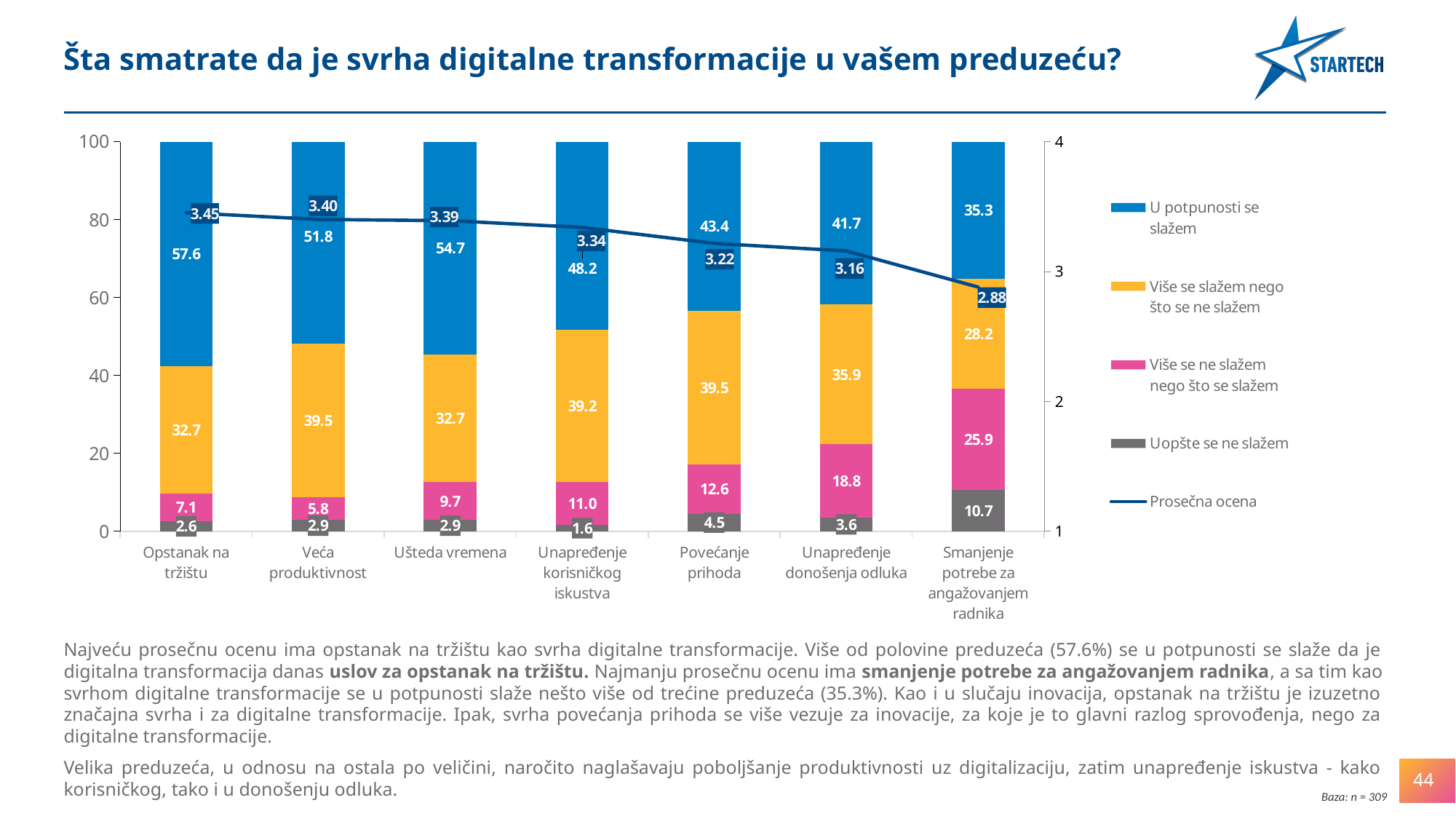
Which category has the highest average score (Prosečna ocena)? Opstanak na tržištu Which category has the lowest value for "U potpunosti se slažem"? Smanjenje potrebe za angažovanjem radnika What is the value of "Uopšte se ne slažem" for "Unapređenje korisničkog iskustva"? 1.6 What is the value of "Više se slažem nego što se ne slažem" for "Veća produktivnost"? 39.5 What kind of chart is this? Stacked bar chart with a line What is the difference between the "U potpunosti se slažem" values for "Opstanak na tržištu" and "Smanjenje potrebe za angažovanjem radnika"? 22.3 How many categories are shown on the x axis? 7 Does the average score line (Prosečna ocena) rise or fall from left to right across the categories? Fall What is the value of "U potpunosti se slažem" for "Opstanak na tržištu"? 57.6 How many entries does the legend list? 5 What is the average score (Prosečna ocena) for "Smanjenje potrebe za angažovanjem radnika"? 2.88 Which is larger: the "Više se ne slažem nego što se slažem" value for "Unapređenje donošenja odluka" or for "Povećanje prihoda"? Unapređenje donošenja odluka